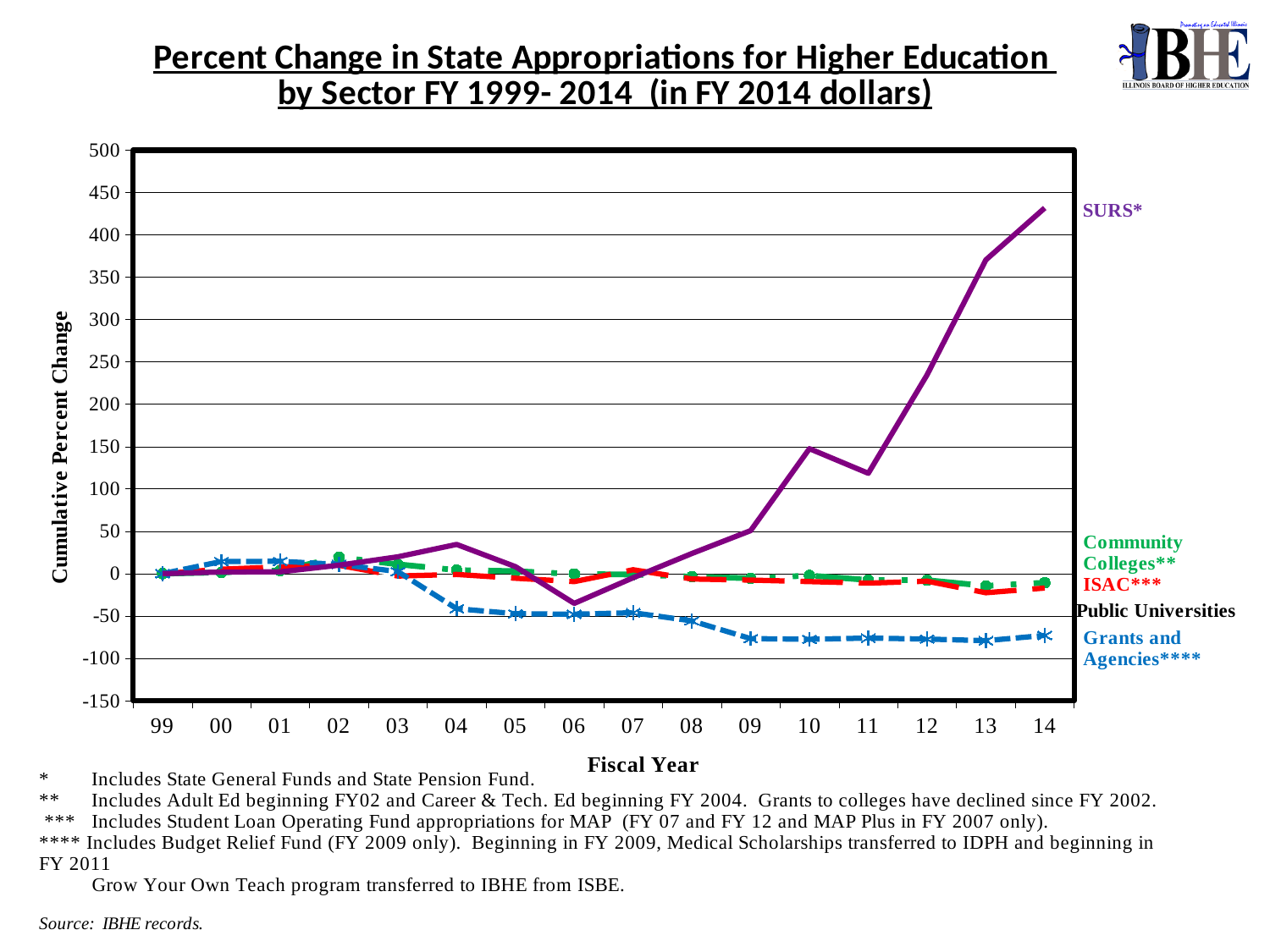
Does the Grants and Agencies**** line rise or fall from FY 03 to FY 09? fall What is the title of the y axis? Cumulative Percent Change Is the value for SURS* in FY 06 greater or less than 0? less Which series has the lowest value in FY 14? Grants and Agencies**** What kind of chart is shown on the slide? line chart Is the value for Grants and Agencies**** in FY 09 greater or less than -50? less Which series has the highest value in FY 14? SURS* Does the SURS* line rise or fall from FY 09 to FY 14? rise Is the value for SURS* in FY 14 greater or less than 400? greater How many fiscal years are plotted along the x axis? 16 How many series are labelled on the chart? 5